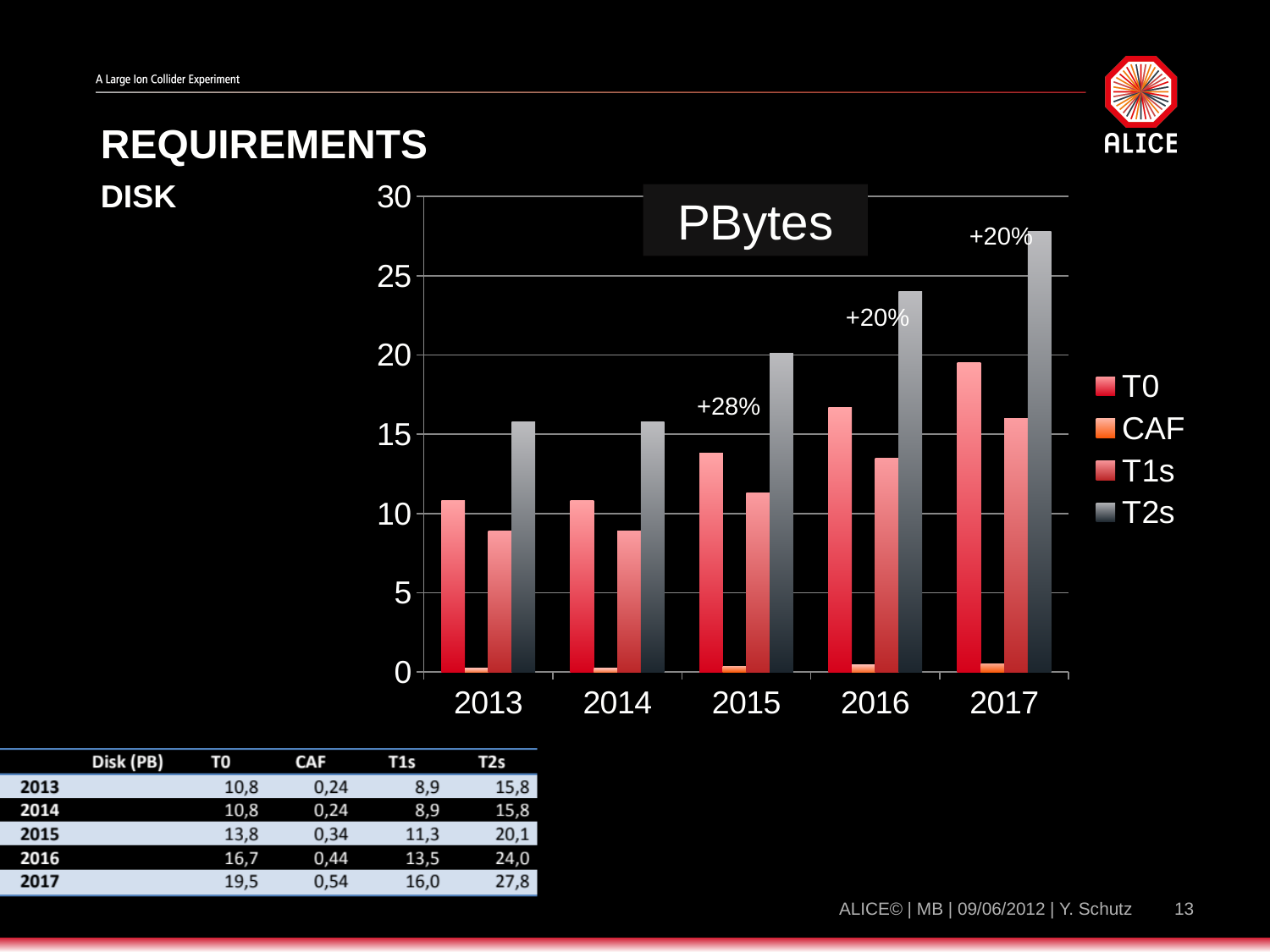
How many series does the chart legend list? 4 How many years are shown on the x axis of the chart? 5 According to the table, what is the CAF disk value for 2016? 0,44 Which is larger in 2016, the T0 value or the T1s value? T0 What percentage increase is annotated above the 2015 bars? +28% According to the table, what is the T2s disk value for 2017? 27,8 According to the table, what is the T0 disk value for 2015? 13,8 Which series has the lowest values in every year? CAF What type of chart is shown on the slide? bar chart Do the T2s values rise or fall from 2014 to 2017? rise Which year has the highest T2s value? 2017 What is the difference between the T2s values for 2017 and 2016? 3,8